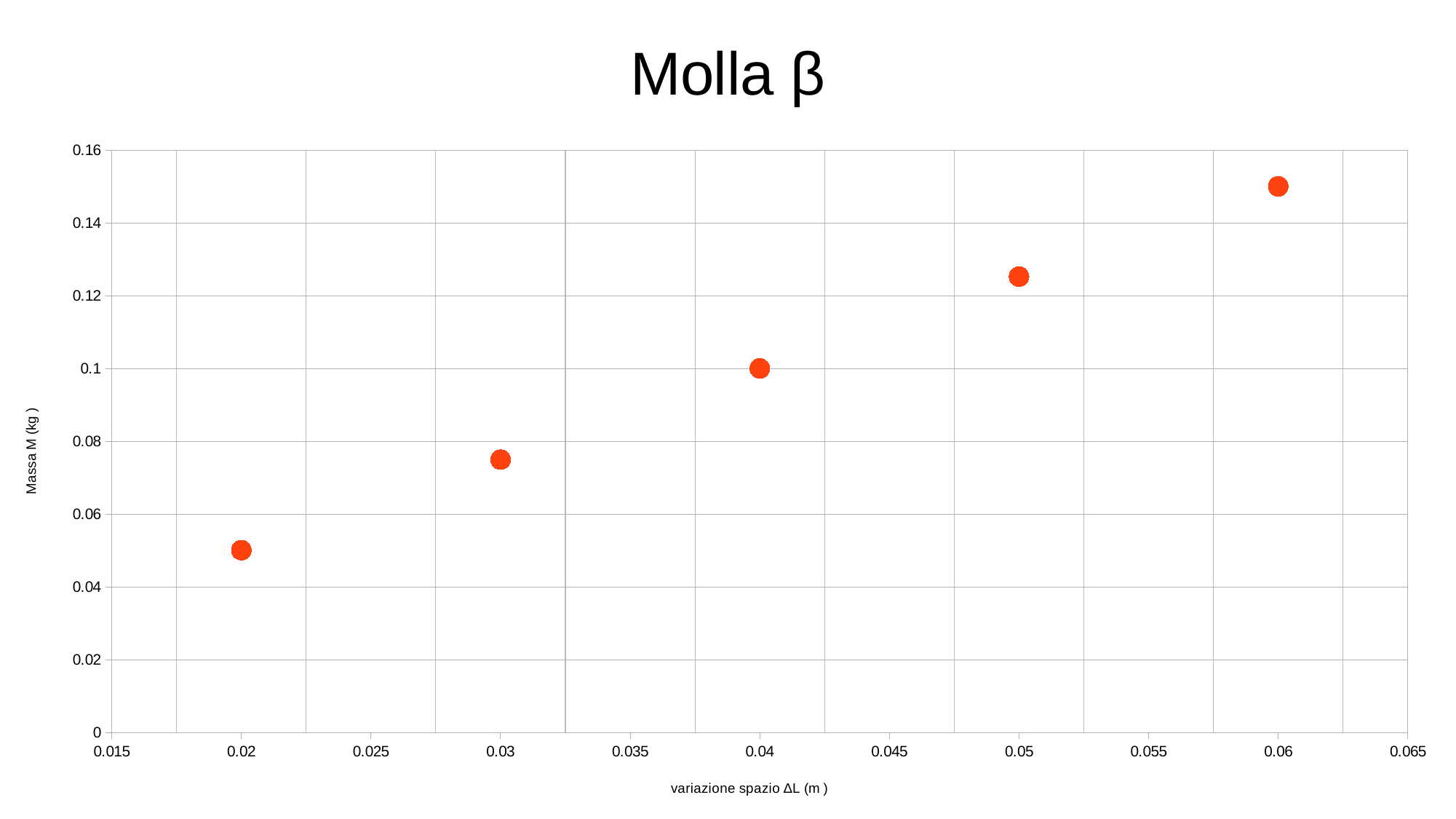
What is the Massa M (kg) value of the point at ΔL = 0.04 m? 0.1 Which point has a larger Massa M: the one at ΔL = 0.03 m or the one at ΔL = 0.05 m? 0.05 At which ΔL value is the Massa M lowest? 0.02 How many data points are plotted in the chart? 5 Do the Massa M values rise or fall as ΔL increases along the x axis? rise Is the Massa M value for the point at ΔL = 0.06 m greater or less than 0.14? greater At which ΔL value is the Massa M highest? 0.06 What is the title of the chart? Molla β What kind of chart is shown on the slide? scatter plot Is the Massa M value for the point at ΔL = 0.05 m greater or less than 0.12? greater Is the Massa M value for the point at ΔL = 0.02 m greater or less than 0.06? less